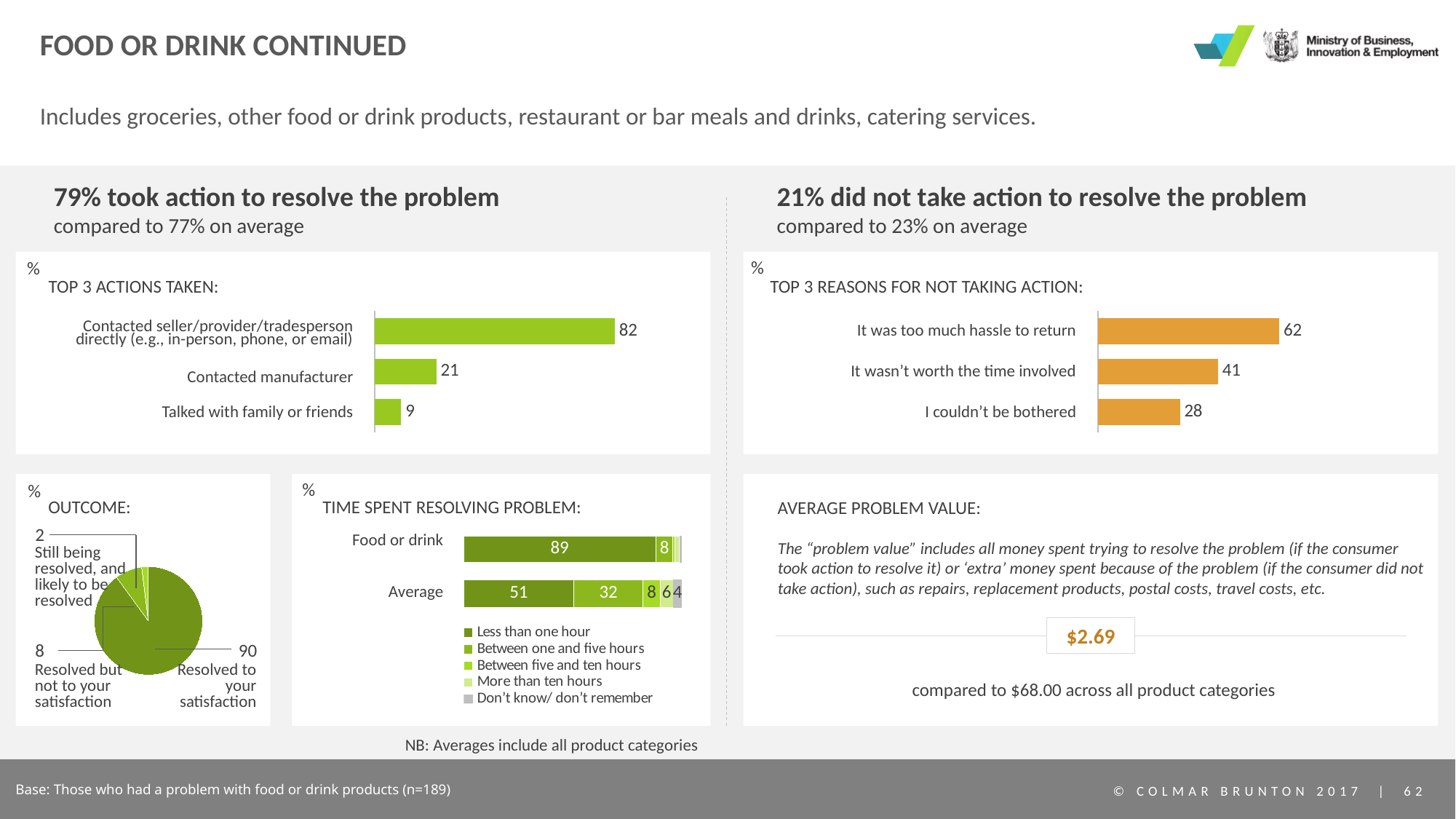
In the TIME SPENT RESOLVING PROBLEM chart, how many series does the legend list? 5 In the TOP 3 REASONS FOR NOT TAKING ACTION chart, which reason has the highest value? It was too much hassle to return In the TOP 3 REASONS FOR NOT TAKING ACTION chart, what is the difference between It was too much hassle to return and I couldn't be bothered? 34 In the TOP 3 REASONS FOR NOT TAKING ACTION chart, what is the value for I couldn't be bothered? 28 What kind of chart is the OUTCOME chart? pie chart In the TOP 3 ACTIONS TAKEN chart, how many actions are shown? 3 In the TIME SPENT RESOLVING PROBLEM chart, what is the Less than one hour value for Average? 51 In the TOP 3 ACTIONS TAKEN chart, what is the difference between the values for Contacted seller/provider/tradesperson directly and Talked with family or friends? 73 In the OUTCOME pie chart, what share is Resolved to your satisfaction? 90 In the TOP 3 ACTIONS TAKEN chart, what is the value for Contacted manufacturer? 21 In the TOP 3 REASONS FOR NOT TAKING ACTION chart, which is larger: It wasn't worth the time involved or I couldn't be bothered? It wasn't worth the time involved In the TOP 3 ACTIONS TAKEN chart, which action has the lowest value? Talked with family or friends